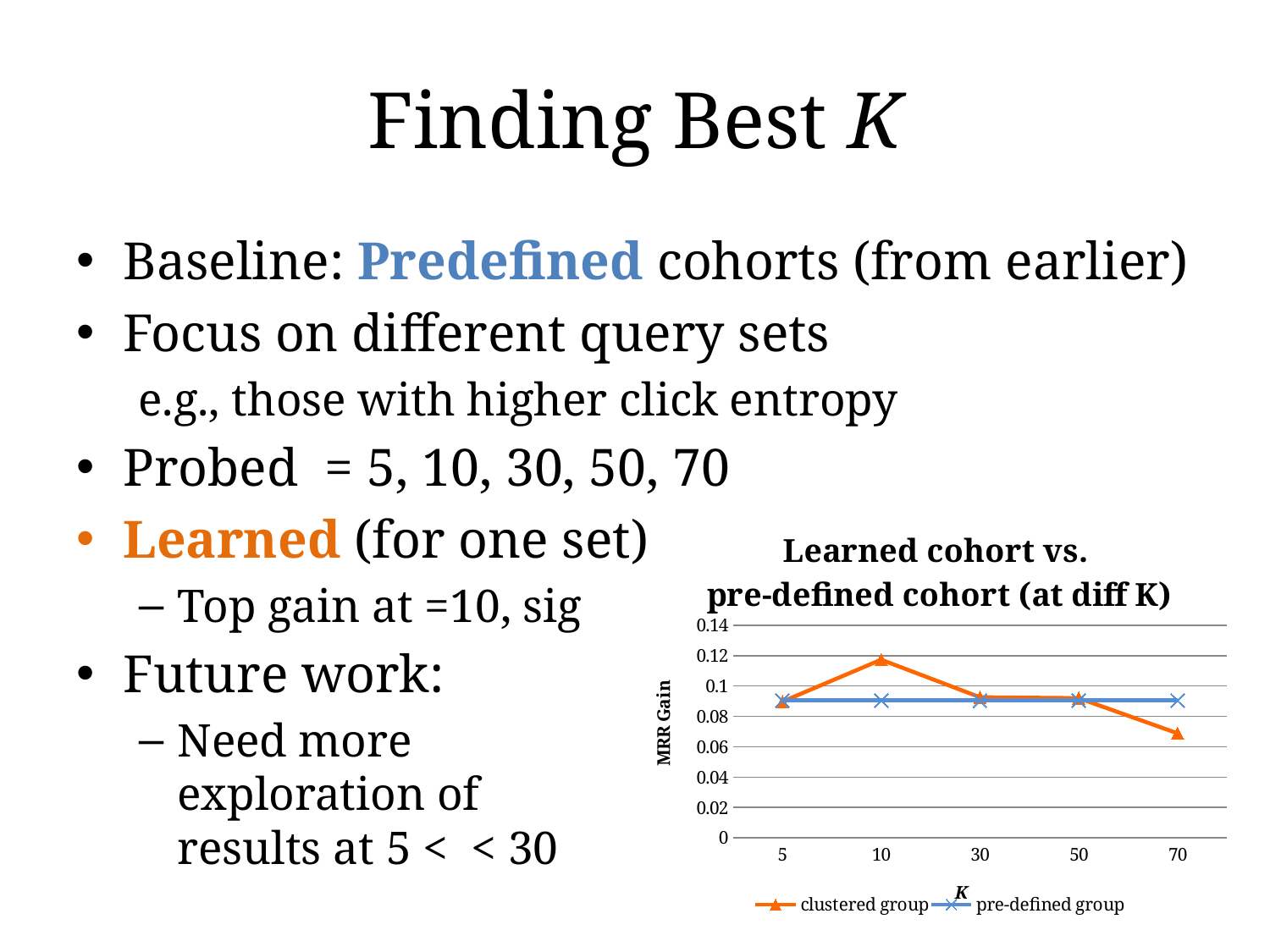
How many series does the chart legend list? 2 How many K values are plotted along the x axis of the chart? 5 At which K does the clustered group series have its lowest MRR Gain? 70 Is the MRR Gain for the pre-defined group at K=5 greater or less than 0.1? less What is the label on the y axis of the chart? MRR Gain At which K does the clustered group series reach its highest MRR Gain? 10 At K=70, which series has the higher MRR Gain, clustered group or pre-defined group? pre-defined group Is the MRR Gain for the clustered group at K=10 greater or less than 0.1? greater What kind of chart is shown on the slide? line chart Does the pre-defined group series rise, fall, or stay flat as K increases from 5 to 70? stay flat Is the MRR Gain for the clustered group at K=70 greater or less than 0.08? less At K=10, which series has the higher MRR Gain, clustered group or pre-defined group? clustered group